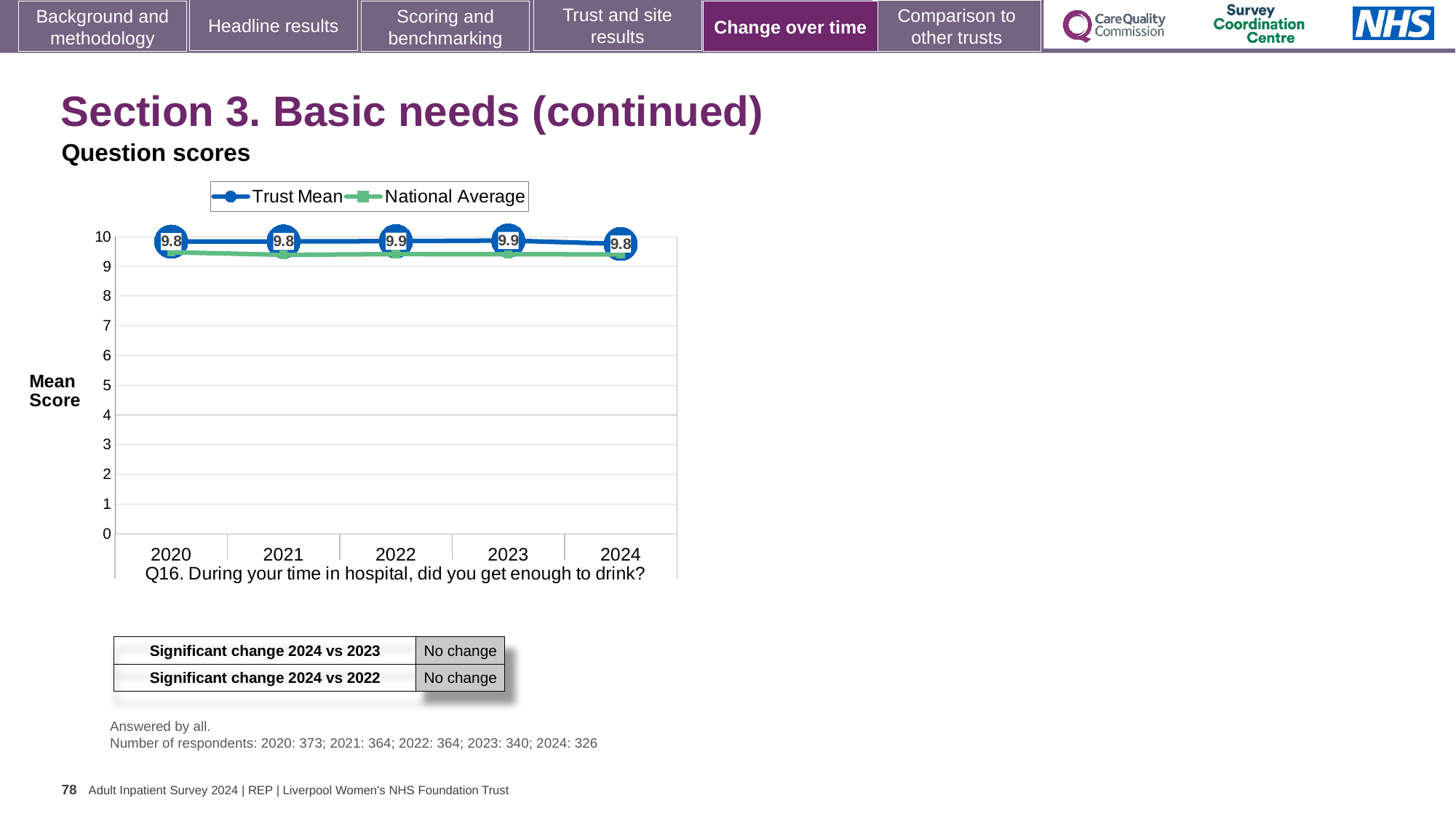
What is the Trust Mean score for 2020? 9.8 What is the label on the y axis of the chart? Mean Score Is the National Average value for 2021 greater or less than 9? greater How many years are plotted on the x axis of the chart? 5 How many series does the chart legend list? 2 What is the Trust Mean score for 2022 in the Q16 chart? 9.9 What are the two series named in the chart legend? Trust Mean and National Average In 2024, which is higher: the Trust Mean or the National Average? Trust Mean What is the Trust Mean score for 2024? 9.8 Does the Trust Mean rise or fall from 2021 to 2022? rise What kind of chart is shown on the slide? Line chart What is the difference between the Trust Mean in 2022 and the Trust Mean in 2020? 0.1